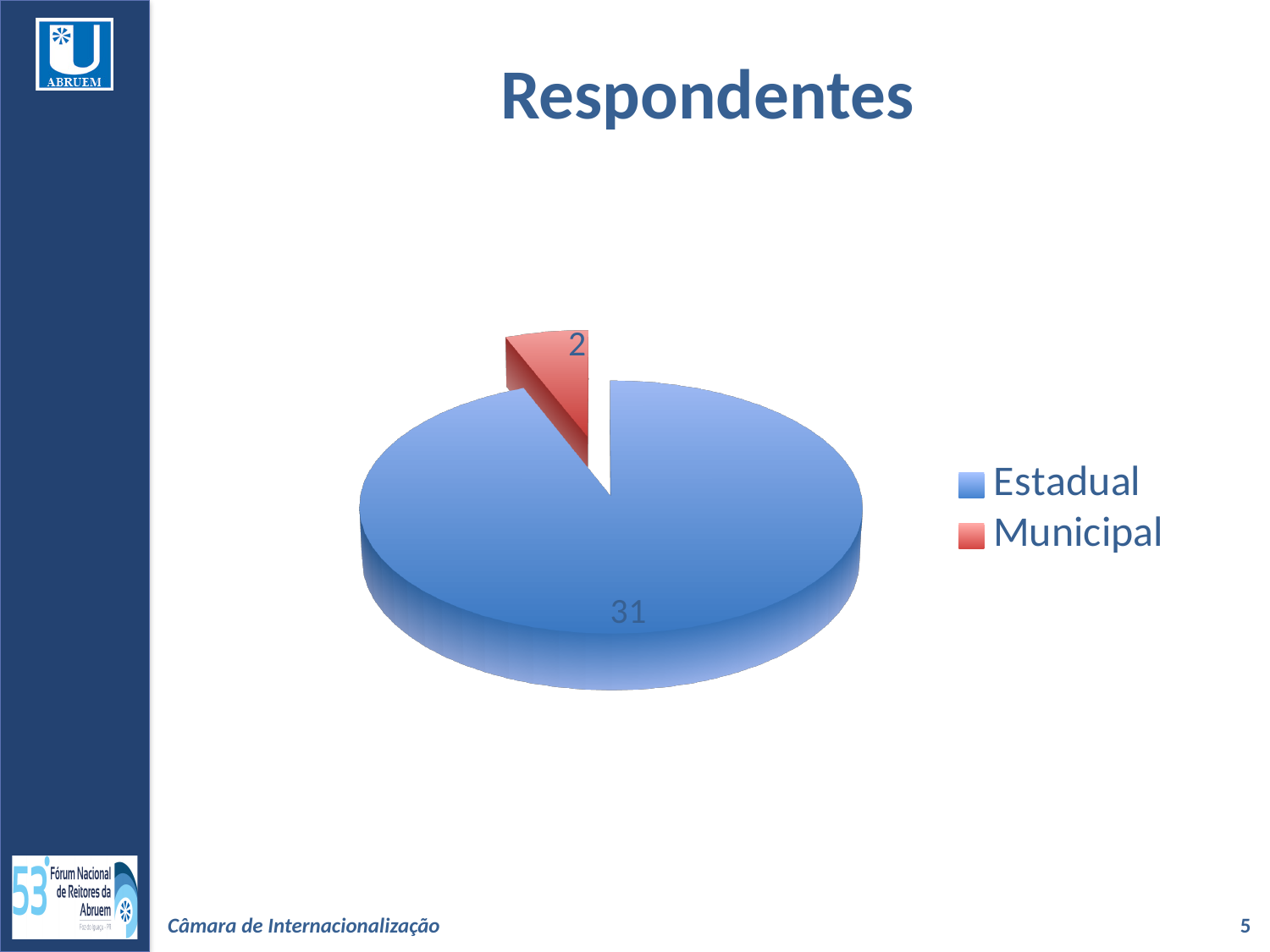
How many entries does the legend list? 2 Which is larger, the value for Estadual or the value for Municipal? Estadual How many categories does the pie chart show? 2 What is the value for Municipal in the pie chart? 2 What is the value for Estadual in the pie chart? 31 What colour is the Municipal slice in the pie chart? Red What kind of chart is shown on the slide? Pie chart Which category has the largest slice of the pie chart? Estadual What is the title of the chart on the slide? Respondentes What is the total of all slices in the pie chart? 33 What is the difference between the Estadual and Municipal values? 29 Which category has the smallest slice of the pie chart? Municipal